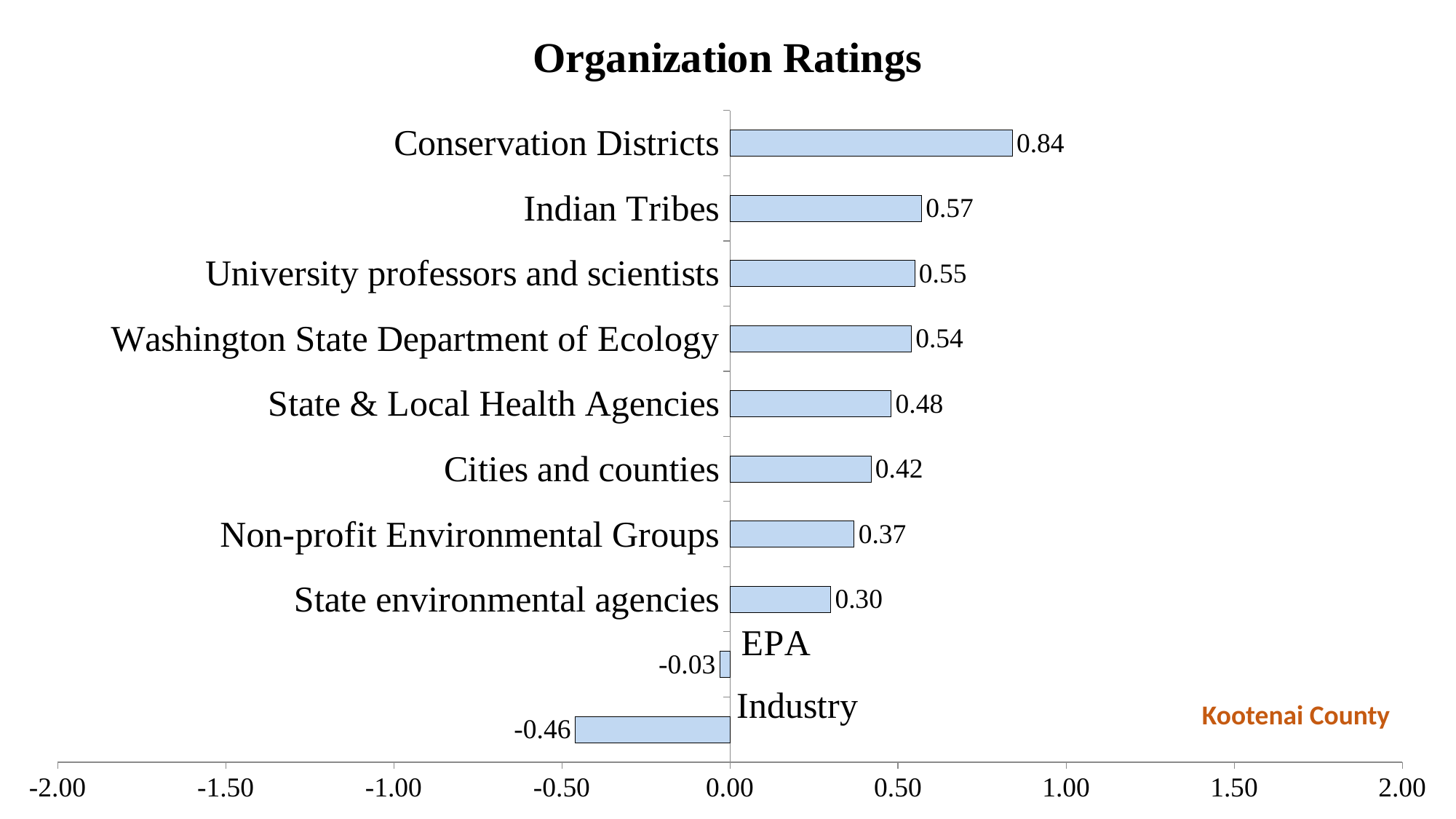
Which organization has the highest rating? Conservation Districts What is the rating for EPA? -0.03 How many organizations are shown in the chart? 10 Which organization has the lowest rating? Industry What is the rating for Conservation Districts? 0.84 Is the rating for State environmental agencies greater or less than 0.50? less What is the difference between the ratings for Conservation Districts and Indian Tribes? 0.27 What is the title of the chart? Organization Ratings What kind of chart is shown on the slide? Bar chart What is the rating for Industry? -0.46 What is the rating for State & Local Health Agencies? 0.48 Which has a higher rating, Cities and counties or Non-profit Environmental Groups? Cities and counties